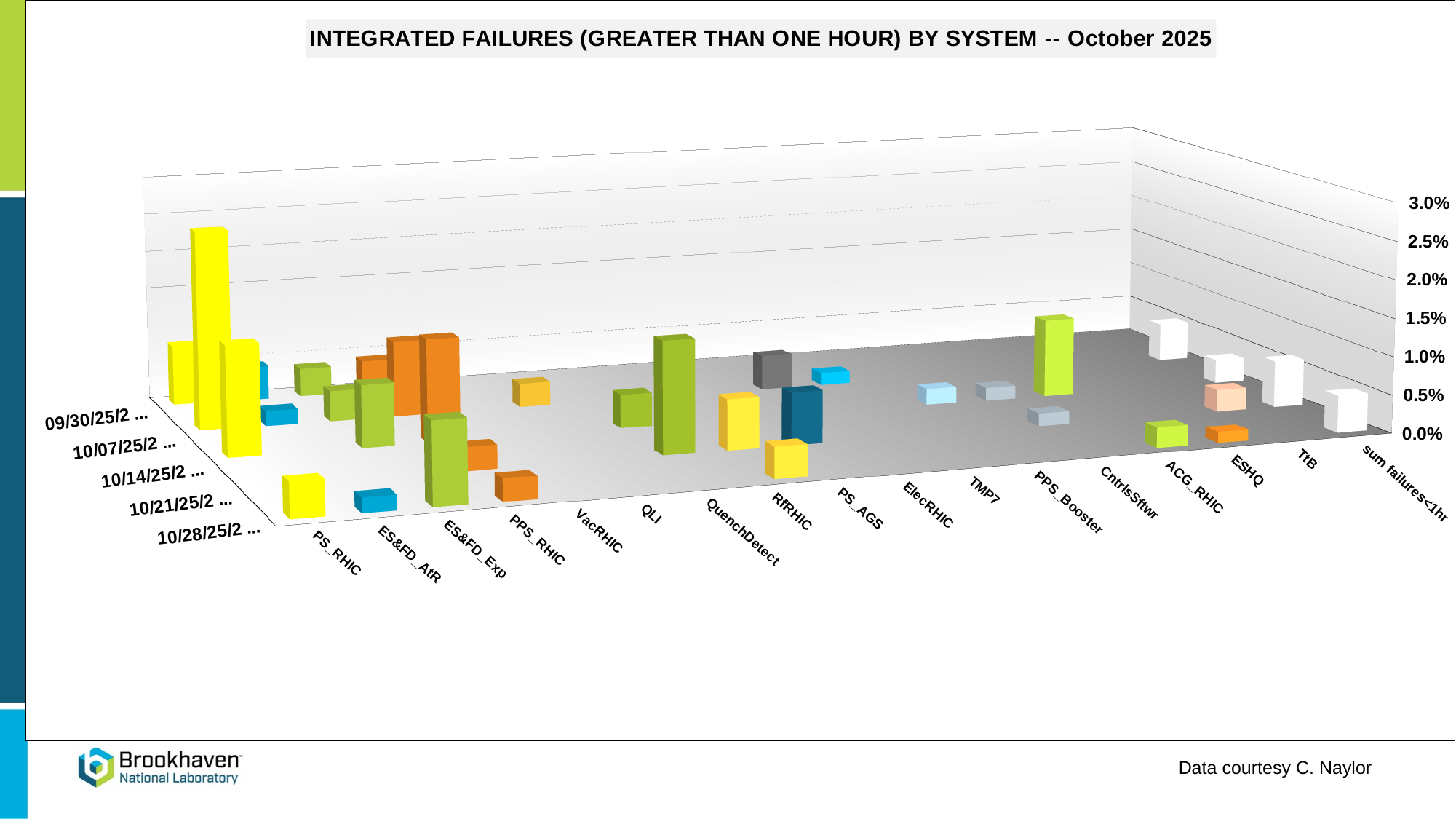
What is the first date label shown on the depth axis of the chart? 09/30/25/2 ... How many system categories are shown along the horizontal axis of the chart? 17 What kind of chart is shown on the slide? 3D bar chart Which system has the tallest bar in the chart? PS_RHIC Is the tallest bar for TMP7 greater or less than 1.0%? less Is the tallest bar for ElecRHIC greater or less than 1.0%? less Is the tallest bar for PS_RHIC greater or less than 1.5%? greater What is the highest value shown on the vertical axis of the chart? 3.0% Which has a taller bar in the chart, PS_RHIC or ElecRHIC? PS_RHIC Which has a taller bar in the chart, QLI or TMP7? QLI How many weekly date series are shown along the depth axis of the chart? 5 What is the title of the chart? INTEGRATED FAILURES (GREATER THAN ONE HOUR) BY SYSTEM -- October 2025